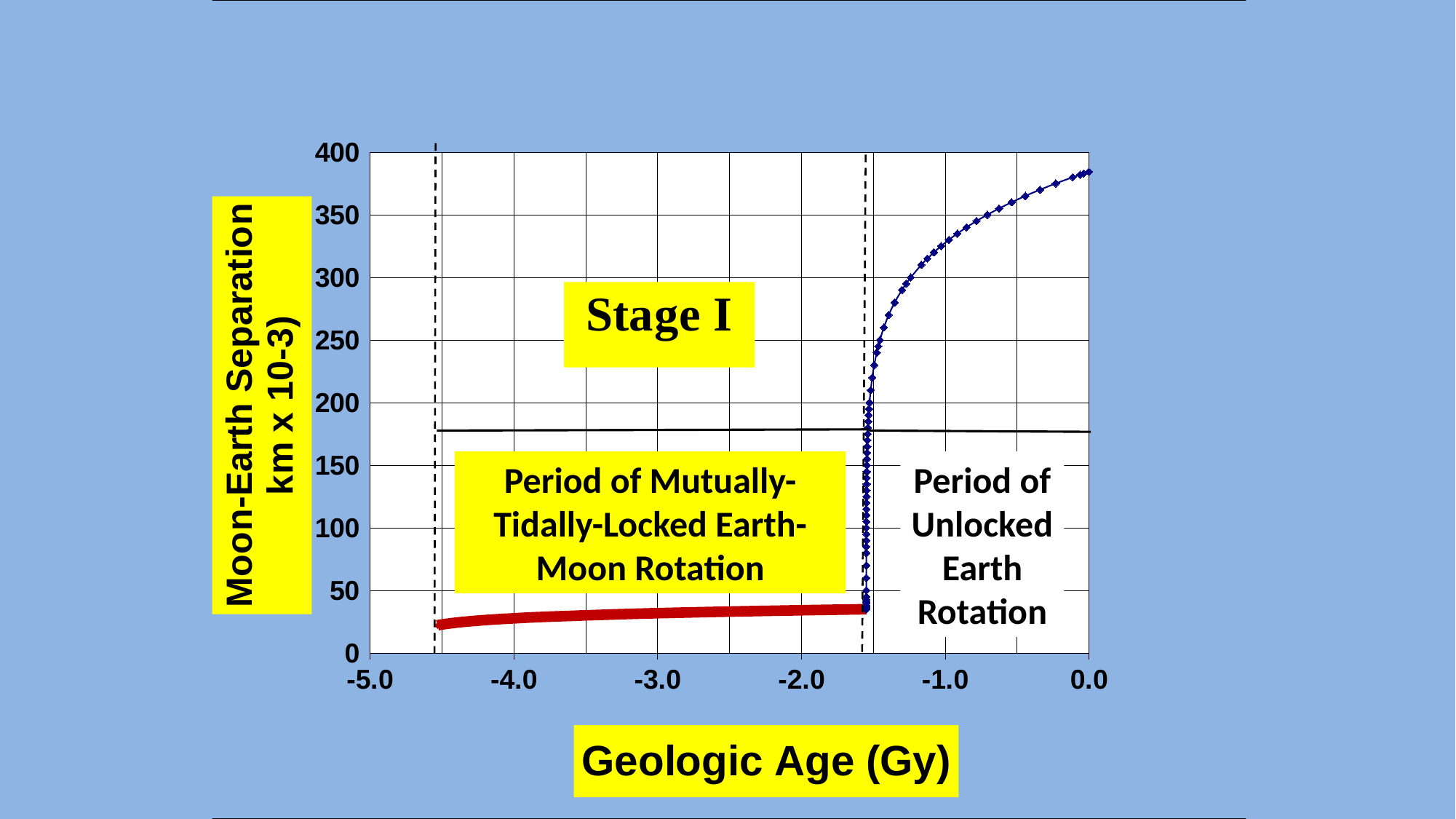
Is the Moon-Earth separation at geologic age -4.0 greater or less than 50? less Is the Moon-Earth separation at geologic age -1.0 greater or less than 300? greater At which geologic age is the Moon-Earth separation highest? 0.0 What is the label of the x axis? Geologic Age (Gy) Which is larger, the Moon-Earth separation at geologic age -2.0 or at geologic age -1.0? -1.0 Is the Moon-Earth separation at geologic age 0.0 greater or less than 350? greater What kind of chart is shown on the slide? line chart What is the label of the y axis? Moon-Earth Separation (km x 10-3) What is the highest value shown on the y axis? 400 Does the Moon-Earth separation rise or fall as geologic age moves from -5.0 toward 0.0? rise